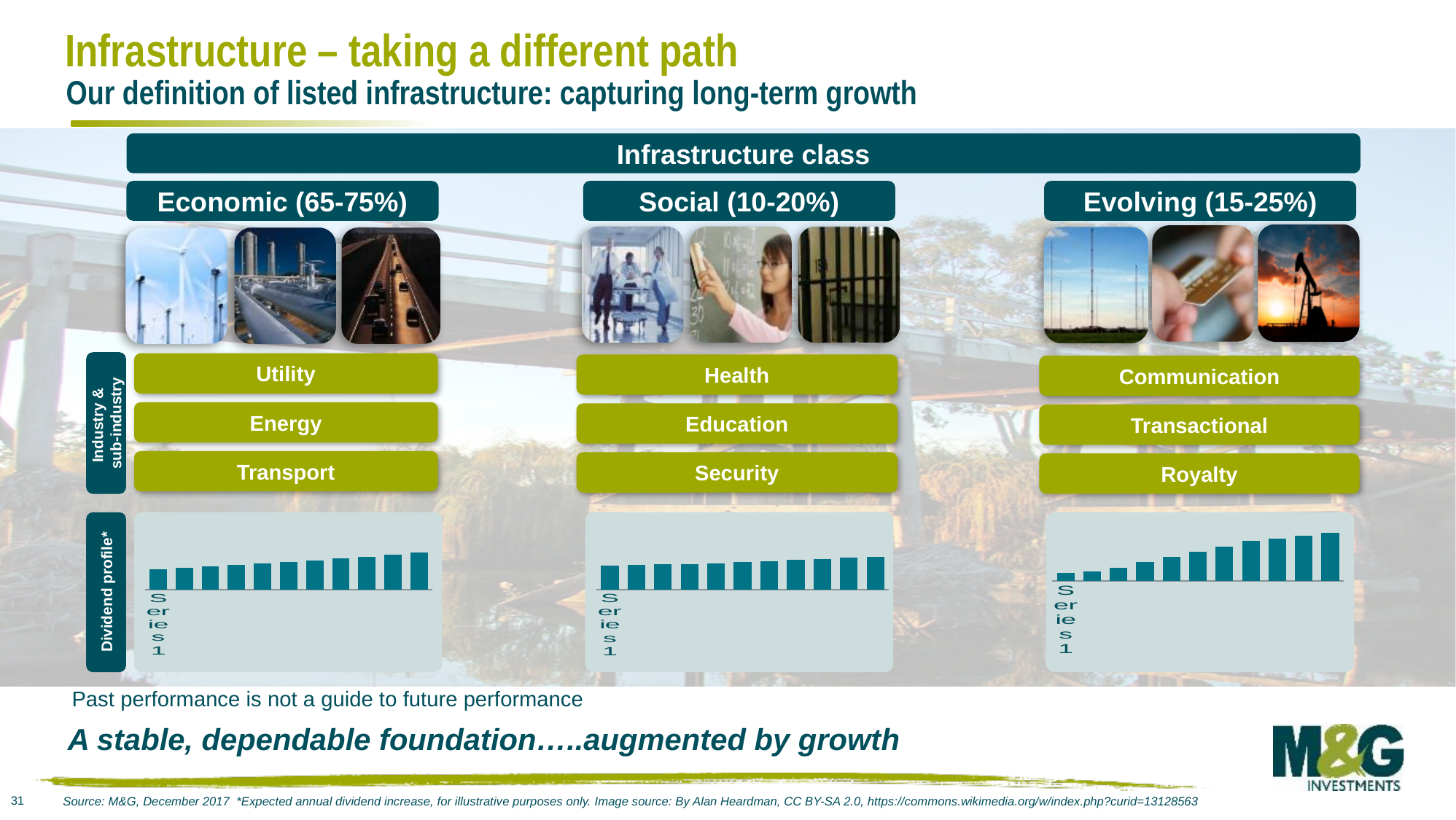
In the Economic Dividend profile chart, do the bars rise or fall from left to right? rise What series label is shown on the Dividend profile charts? Series 1 What kind of chart is used for the Dividend profile under the Evolving class? bar chart In the Evolving Dividend profile chart, is the shortest bar on the left or the right side of the chart? left In the Evolving Dividend profile chart, is the tallest bar on the left or the right side of the chart? right Which of the three Dividend profile charts shows the flattest profile? Social What kind of chart is used for the Dividend profile under the Economic class? bar chart In the Social Dividend profile chart, do the bars rise, fall or stay roughly flat from left to right? rise What kind of chart is used for the Dividend profile under the Social class? bar chart What colour are the bars in the Dividend profile charts? teal Which of the three Dividend profile charts shows the steepest increase from left to right? Evolving In the Evolving Dividend profile chart, do the bars rise or fall from left to right? rise